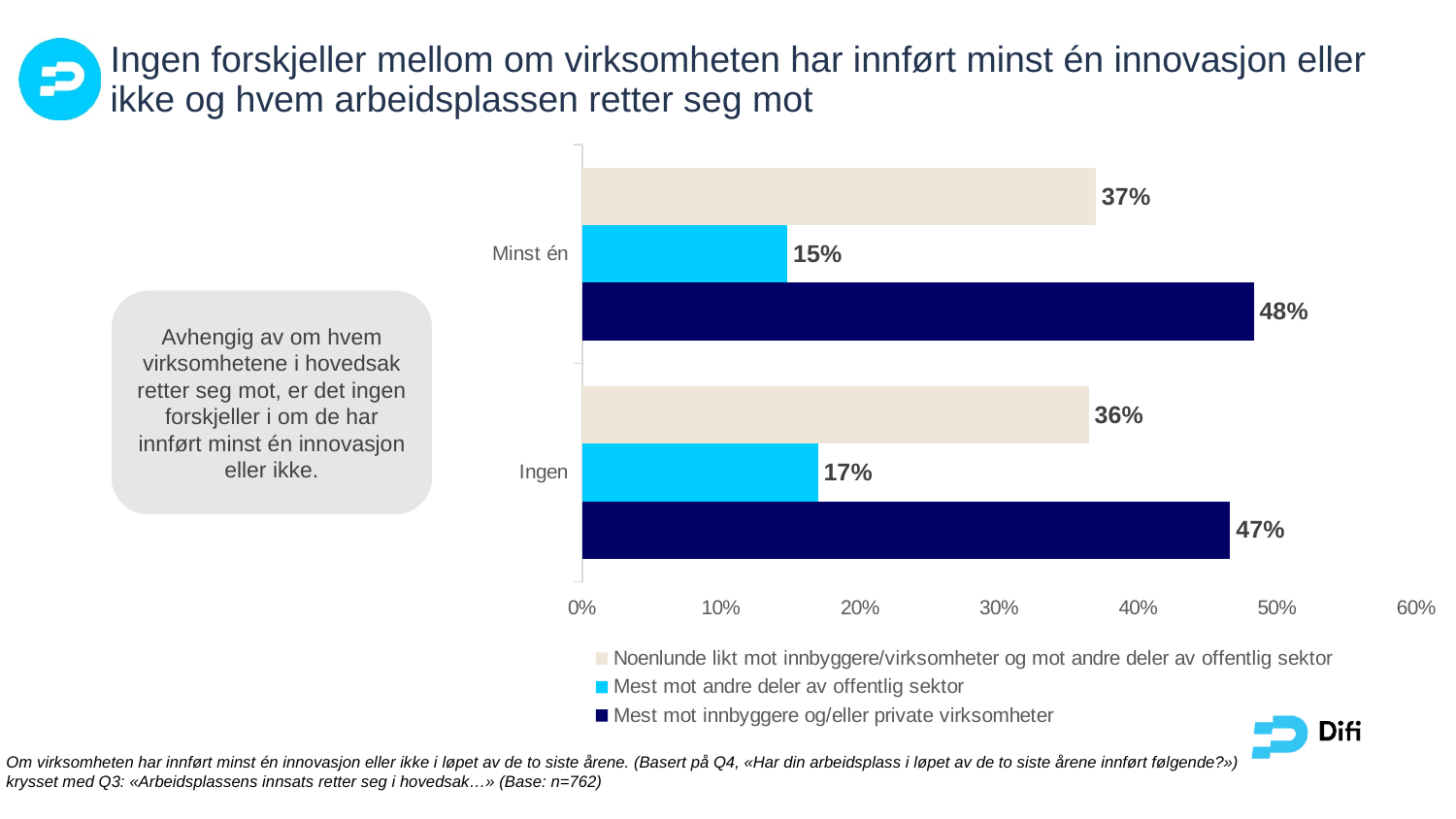
Is the value for "Mest mot innbyggere og/eller private virksomheter" in the "Ingen" category greater or less than 40%? greater What is the value for "Mest mot innbyggere og/eller private virksomheter" in the "Minst én" category? 48% What is the value for "Noenlunde likt mot innbyggere/virksomheter og mot andre deler av offentlig sektor" in the "Minst én" category? 37% What is the difference between the "Mest mot innbyggere og/eller private virksomheter" value and the "Mest mot andre deler av offentlig sektor" value in the "Minst én" category? 33% What is the value for "Mest mot andre deler av offentlig sektor" in the "Ingen" category? 17% Which is larger: the "Noenlunde likt" value for "Minst én" or for "Ingen"? Minst én What is the highest value shown on the x axis? 60% What kind of chart is shown on the slide? Bar chart Which series has the lowest value in the "Minst én" category? Mest mot andre deler av offentlig sektor How many categories are shown on the chart? 2 How many series does the legend list? 3 Which series has the highest value in the "Ingen" category? Mest mot innbyggere og/eller private virksomheter